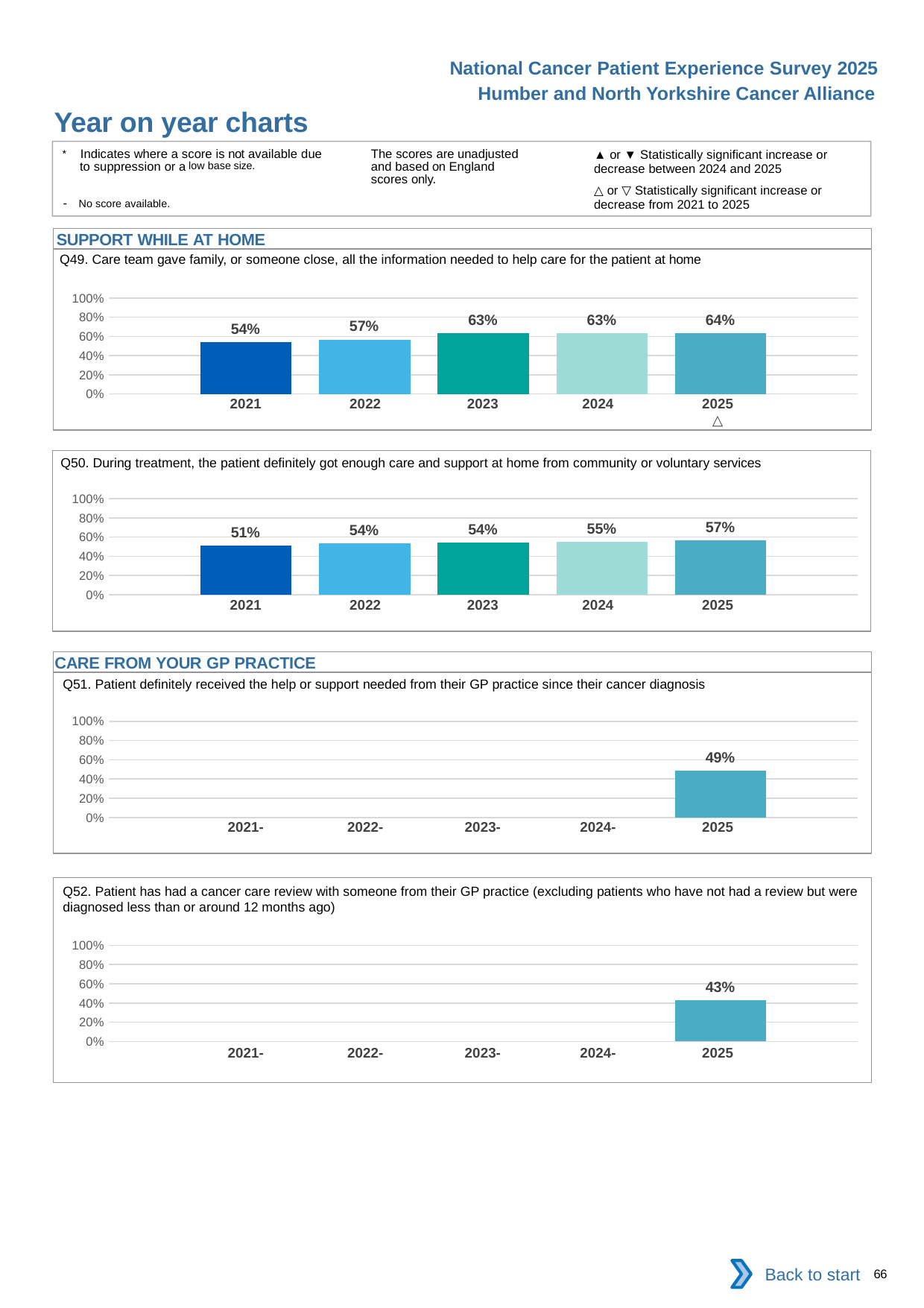
In the Q49 chart, which year has the lowest value? 2021 In the Q50 chart, which year has the highest value? 2025 In the Q49 chart, what is the difference between the 2025 and 2021 values? 10 percentage points What kind of chart is the Q52 chart? bar chart In the Q50 chart, how many years have a bar plotted? 5 In the Q49 chart, what is the value for 2025? 64% In the Q51 chart, what is the value for 2025? 49% In the Q50 chart, what is the value for 2022? 54% In the Q51 chart, how many years have a bar plotted? 1 In the Q52 chart, what is the value for 2025? 43% In the Q50 chart, is the value for 2021 greater or less than 60%? less In the Q49 chart, do the values generally rise or fall from 2021 to 2025? rise